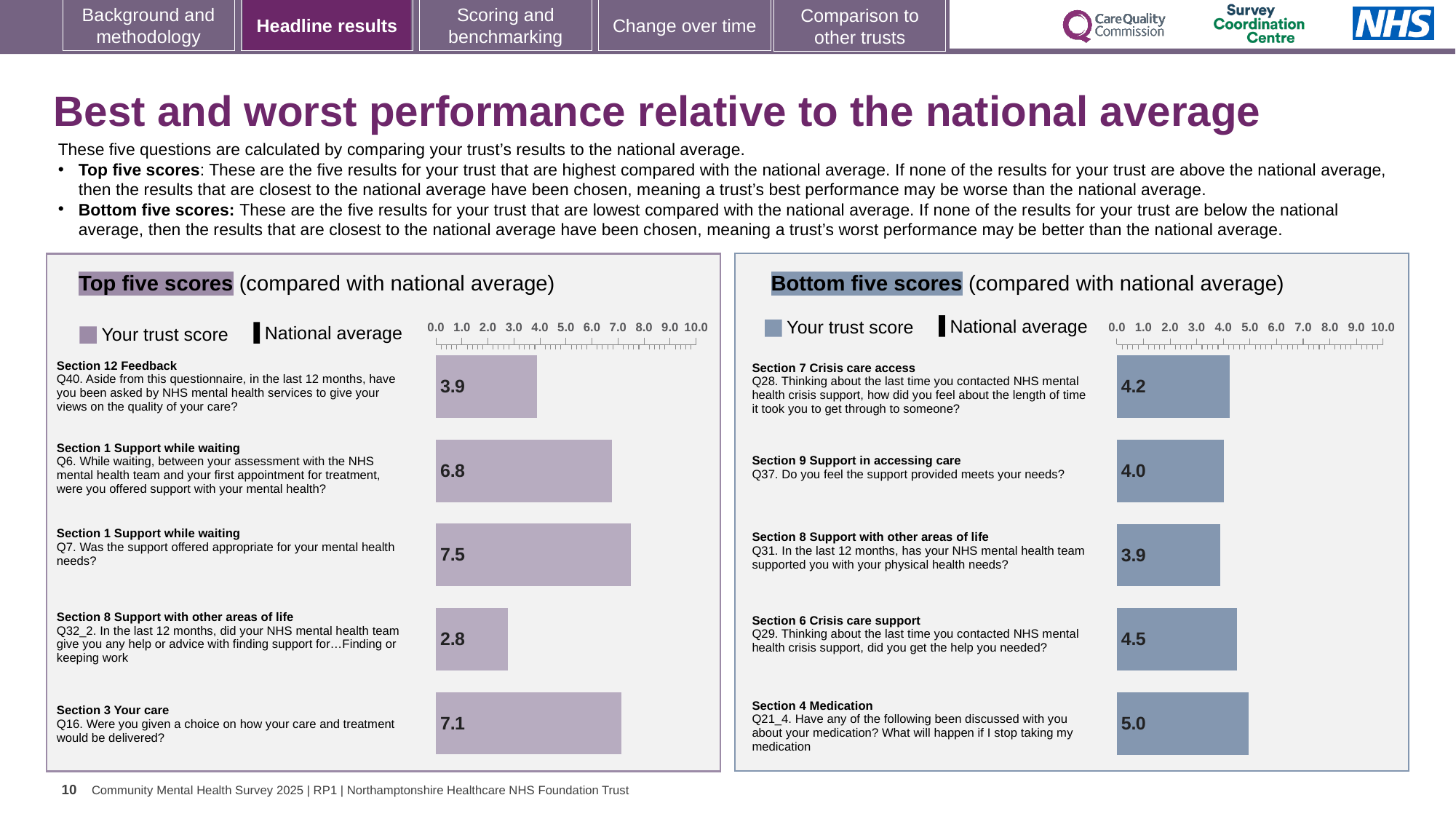
How many bars are plotted in the Bottom five scores chart? 5 In the Top five scores chart, which has the larger trust score, Q6 or Q16? Q16 In the Bottom five scores chart, what is the trust score for Q21_4 (What will happen if I stop taking my medication)? 5.0 What type of chart is the Top five scores chart? Bar chart In the Top five scores chart, which question has the lowest trust score? Q32_2 In the Top five scores chart, what is the trust score for Q7 (Was the support offered appropriate for your mental health needs?)? 7.5 In the Top five scores chart, which question has the highest trust score? Q7 In the Top five scores chart, what is the difference between the trust scores for Q7 and Q32_2? 4.7 In the Bottom five scores chart, which question has the lowest trust score? Q31 In the Bottom five scores chart, which question has the highest trust score? Q21_4 How many series does the legend of the Bottom five scores chart list? 2 In the Bottom five scores chart, what is the difference between the trust scores for Q29 and Q37? 0.5